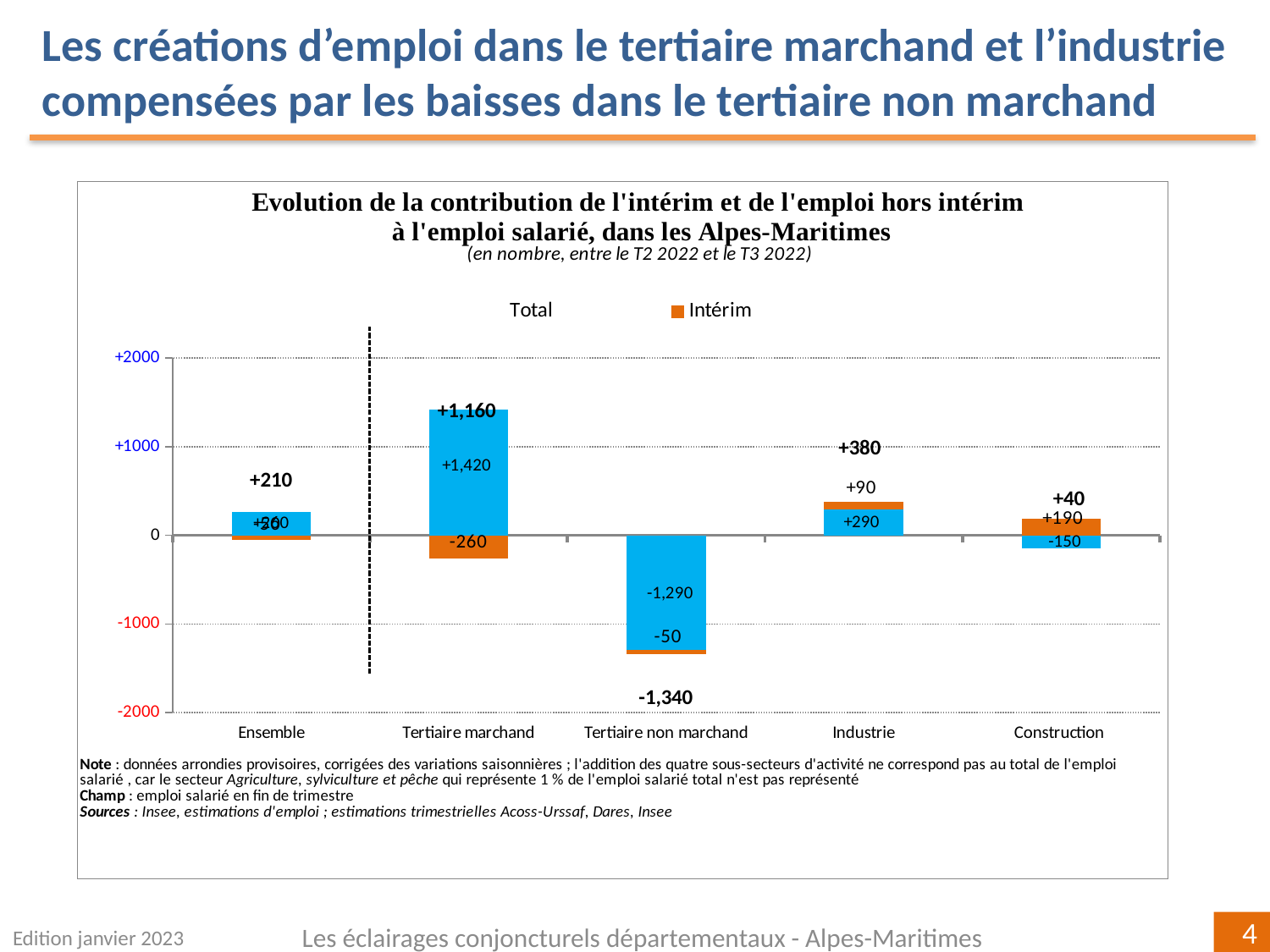
What is the Intérim value for Tertiaire marchand? -260 What is the difference between the total value for Industrie (+380) and the total value for Construction (+40)? 340 What kind of chart is shown on the slide? bar chart Which category has the lowest total value? Tertiaire non marchand Which has the larger total value, Industrie or Construction? Industrie What is the total value shown for Tertiaire marchand? +1,160 What colour represents the Intérim series in the chart? orange What is the total value shown for Tertiaire non marchand? -1,340 What is the Intérim value for Industrie? +90 How many categories are shown on the x axis of the chart? 5 What is the Intérim value for Construction? +190 Which category has the highest total value? Tertiaire marchand